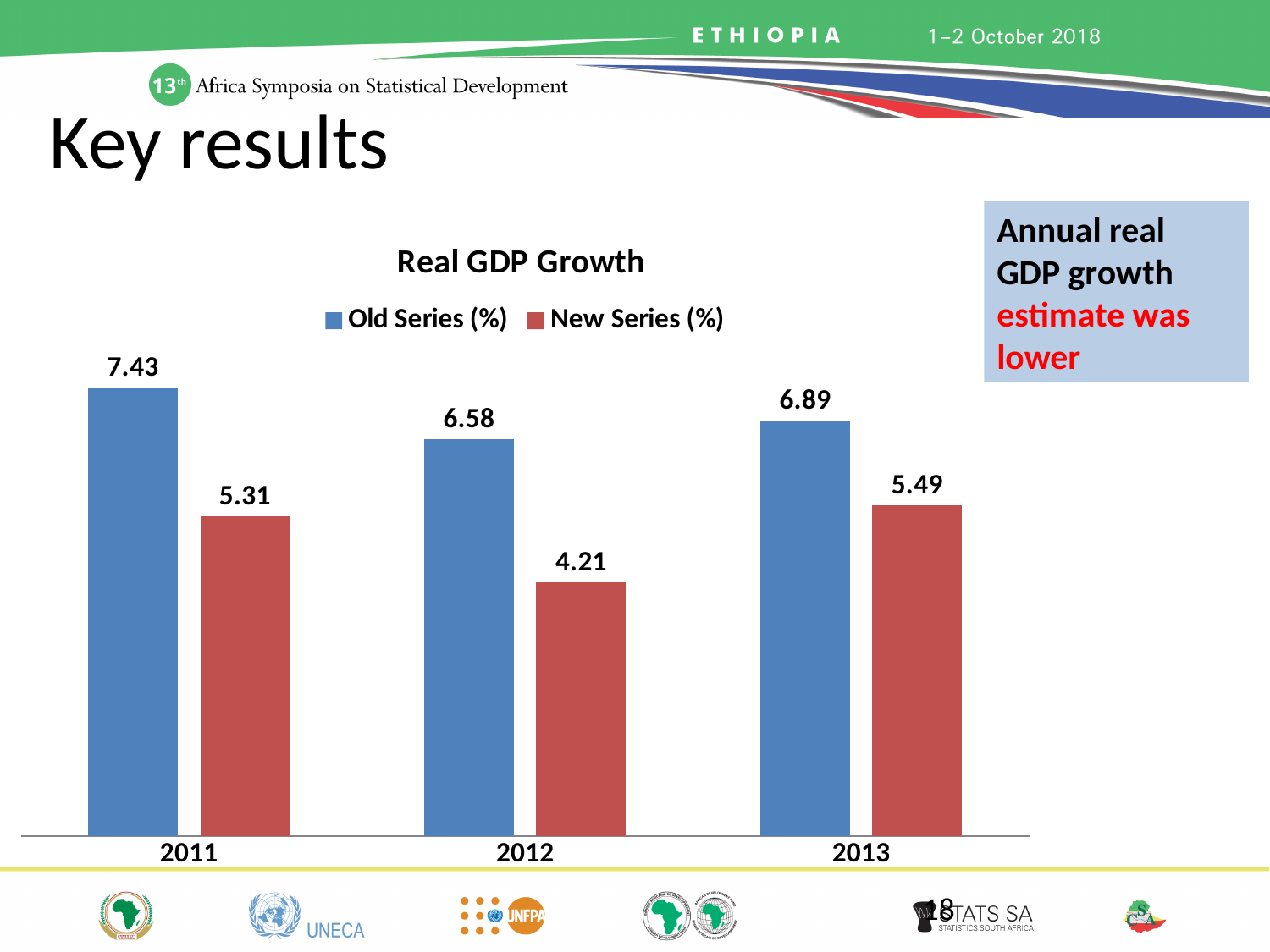
Which year has the highest Old Series (%) value? 2011 Which is larger for 2013, the Old Series (%) value or the New Series (%) value? Old Series (%) What is the Old Series (%) value for 2011? 7.43 What kind of chart is shown? Bar chart How many years are shown on the x axis? 3 Which colour represents the New Series (%) in the chart? Red Which year has the lowest New Series (%) value? 2012 What is the title of the chart? Real GDP Growth What is the New Series (%) value for 2012? 4.21 What is the New Series (%) value for 2013? 5.49 What is the difference between the Old Series (%) and New Series (%) values for 2012? 2.37 How many series does the legend list? 2